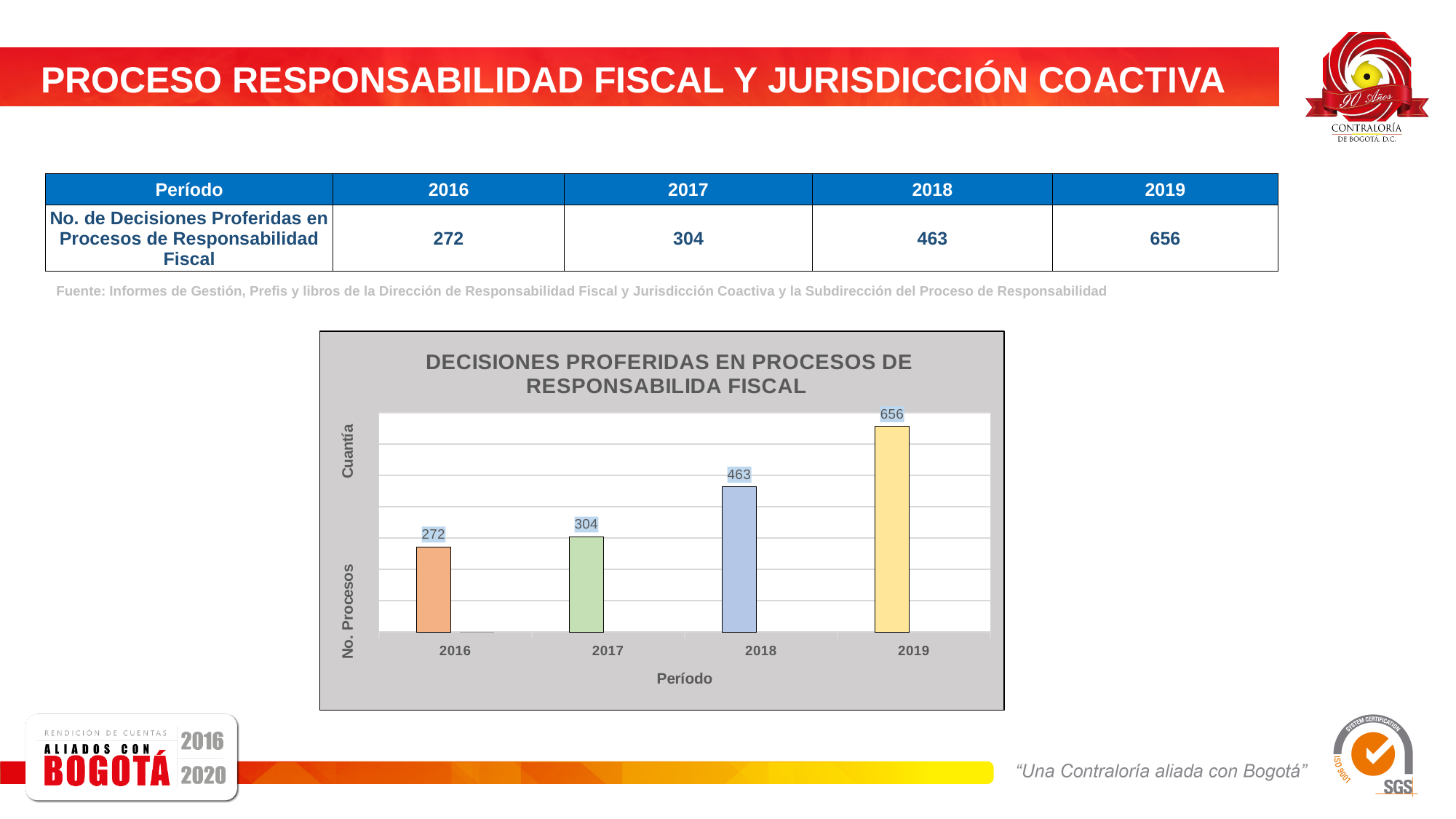
Do the values rise or fall from 2016 to 2019? rise What is the value for 2016 in the chart? 272 What is the value for 2018 in the chart? 463 Which year has the lowest value in the chart? 2016 Which is larger, the value for 2017 or the value for 2018? 2018 What kind of chart is shown on the slide? bar chart What is the difference between the values for 2017 and 2016? 32 What is the title of the chart? DECISIONES PROFERIDAS EN PROCESOS DE RESPONSABILIDA FISCAL What is the difference between the values for 2019 and 2018? 193 How many years are shown on the x axis of the chart? 4 Which year has the highest value in the chart? 2019 What is the value for 2019 in the chart? 656